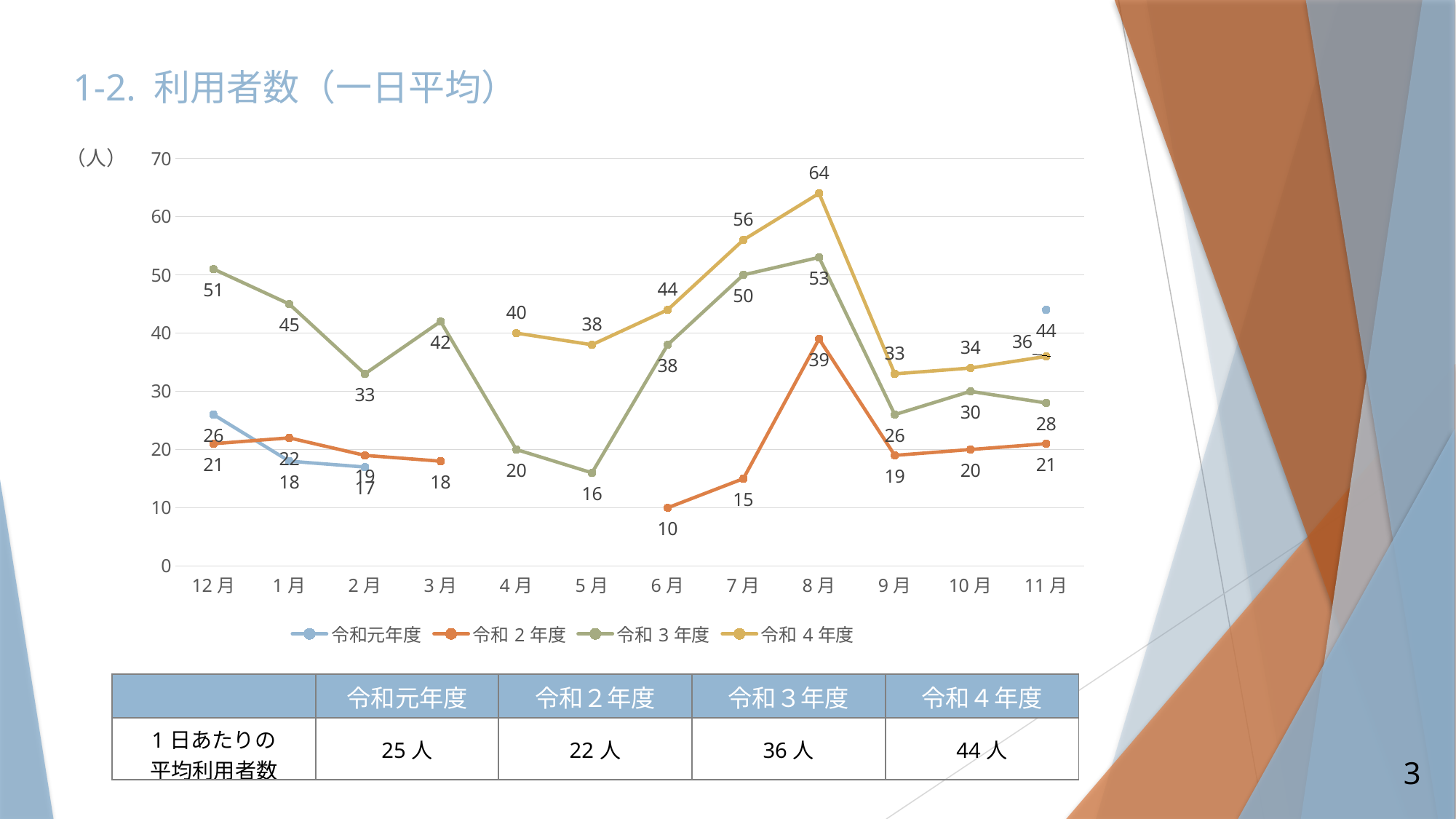
What is the value for 令和３年度 in 12月? 51 What unit is shown at the top of the y axis? （人） What is the value for 令和４年度 in 8月? 64 What is the difference between 令和４年度 and 令和３年度 in 8月? 11 In 7月, which is larger: 令和４年度 or 令和３年度? 令和４年度 In which month does 令和３年度 have its lowest value? 5月 How many series does the legend list? 4 In which month does 令和４年度 reach its highest value? 8月 What is the value for 令和２年度 in 6月? 10 Does the 令和元年度 line rise or fall from 12月 to 2月? fall What kind of chart is shown on the slide? line chart How many months are shown on the x axis? 12